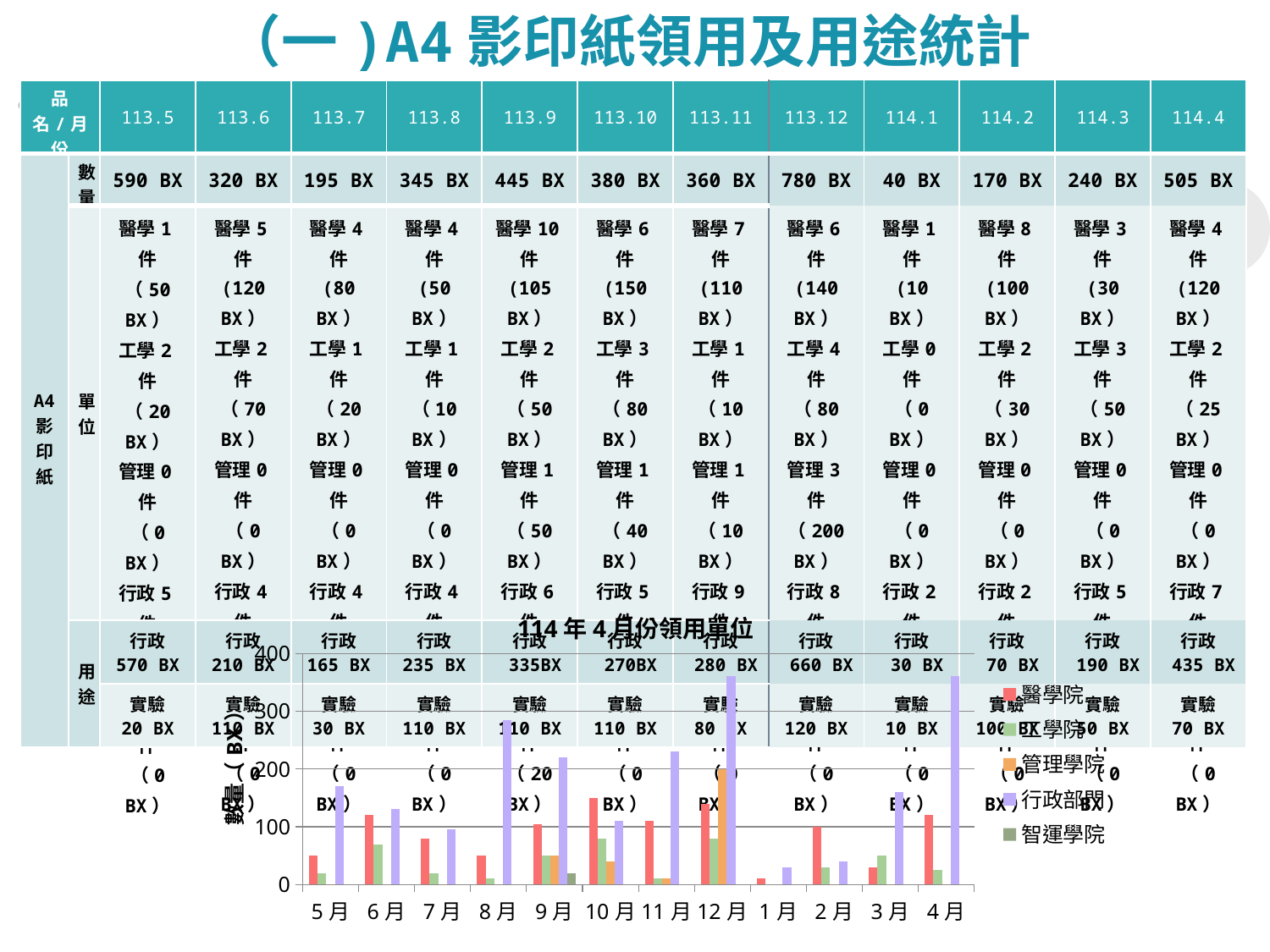
What kind of chart is shown on the slide? bar chart Is the value for 醫學院 in 5月 greater or less than 100? less Which series has the highest bar in 12月? 行政部門 What is the title of the chart? 114年4月份領用單位 Is the value for 行政部門 in 1月 greater or less than 100? less How many months are shown along the x axis of the chart? 12 Which is larger: the 行政部門 value in 12月 or the 行政部門 value in 1月? 12月 Is the value for 醫學院 in 10月 greater or less than 100? greater How many series does the chart legend list? 5 What is the label of the chart's y axis? 數量（BX）